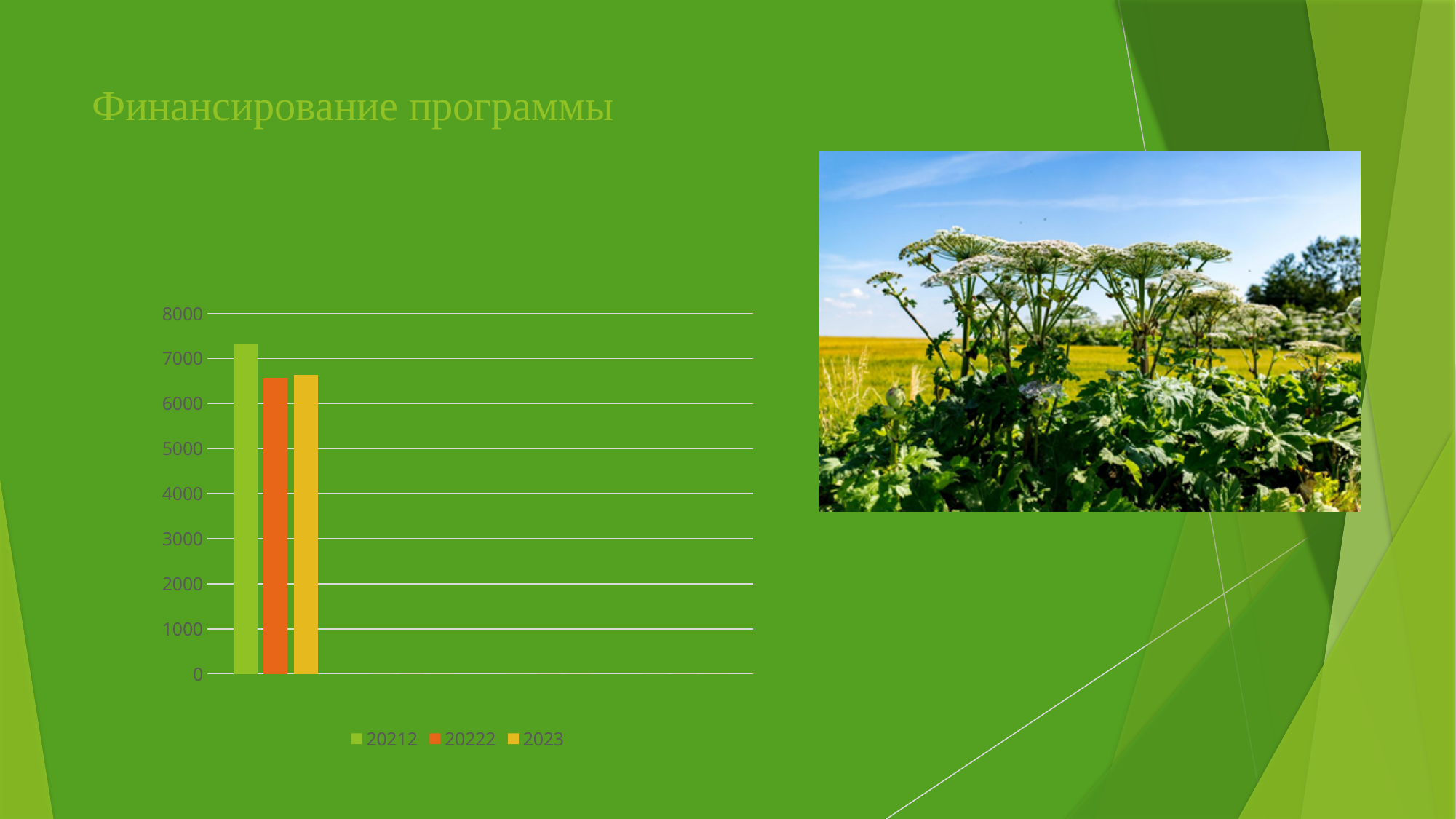
What kind of chart is shown on the slide? bar chart Which series has the highest bar? 20212 Is the value for 20222 greater or less than 7000? less Is the value for 20222 greater or less than 6000? greater How many series does the legend list? 3 Is the value for 2023 greater or less than 7000? less What is the title of the slide containing the chart? Финансирование программы How many bars are plotted in the chart? 3 Which series is shown in orange in the legend? 20222 Which is larger, the value for 20212 or the value for 20222? 20212